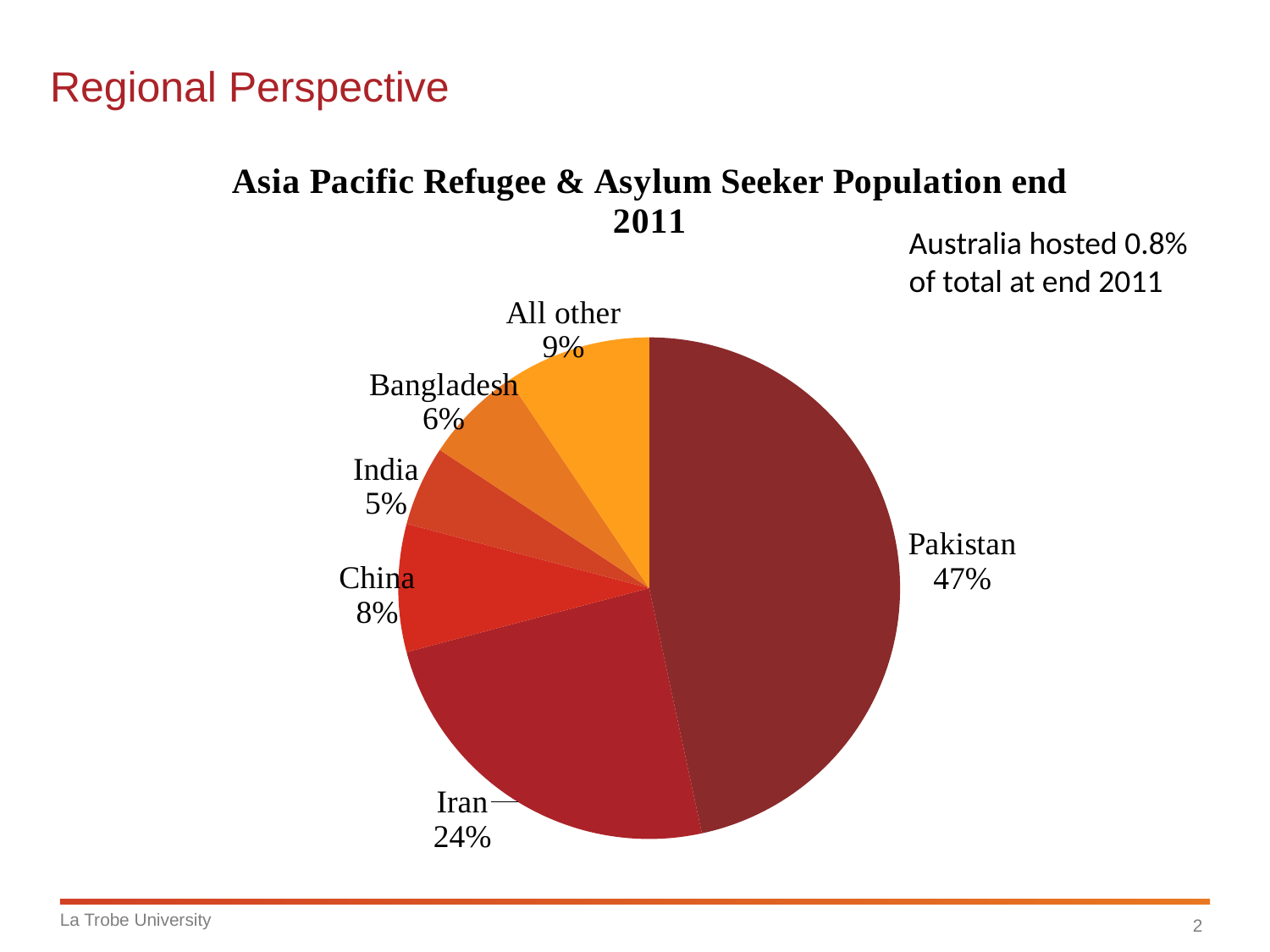
What share of the pie does Pakistan hold? 47% What is the value shown for All other? 9% What share of the pie does Iran hold? 24% What is the value shown for China? 8% Which category has the largest slice of the pie? Pakistan What is the value shown for Bangladesh? 6% What is the difference in percentage points between Pakistan and Iran? 23 Which is larger, the slice for China or the slice for Bangladesh? China What is the title of the chart? Asia Pacific Refugee & Asylum Seeker Population end 2011 What kind of chart is shown on the slide? Pie chart How many slices does the pie chart have? 6 Which category has the smallest slice of the pie? India